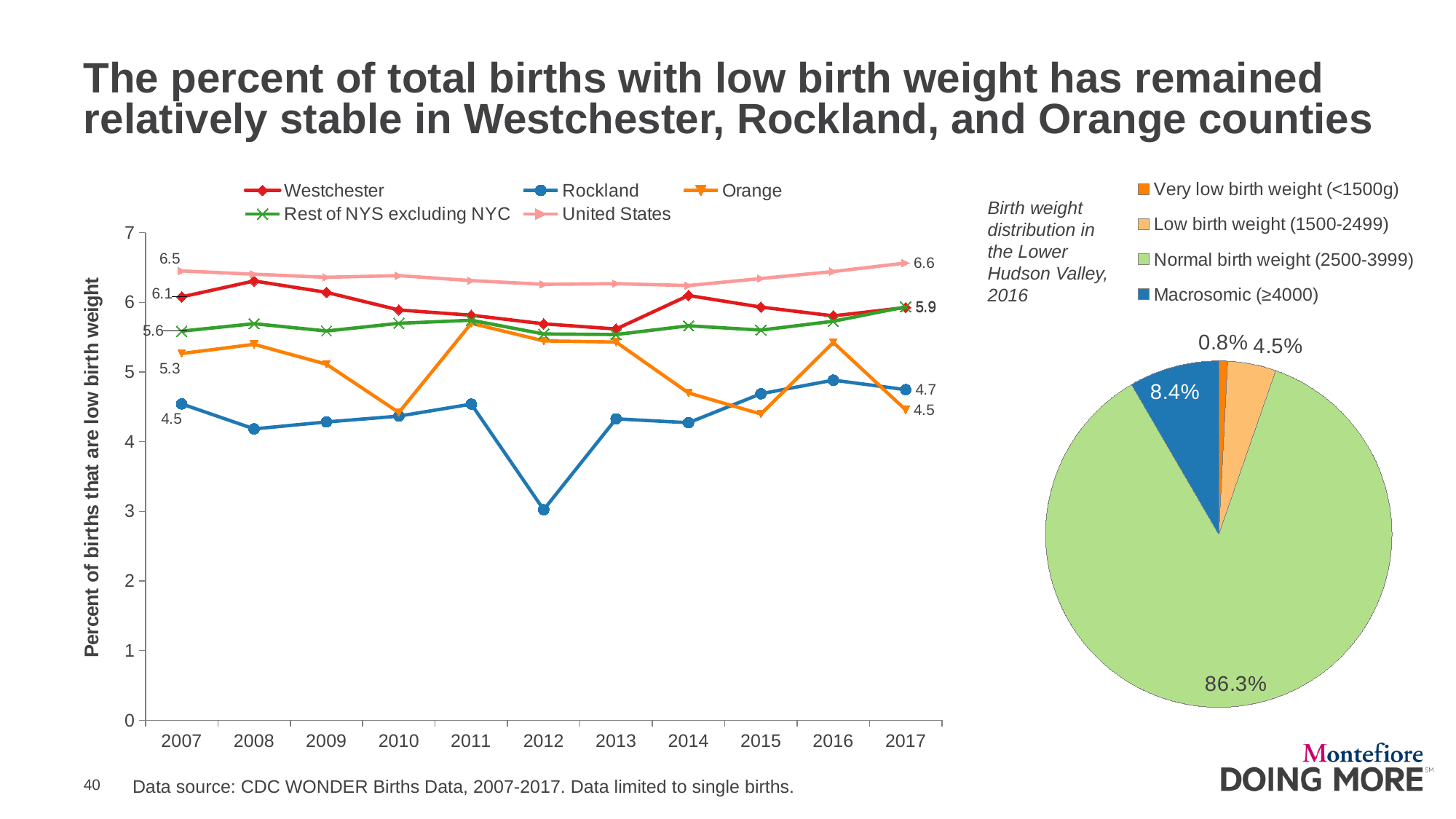
In the line chart on the left, how many years are shown on the x axis? 11 In the line chart on the left, how many series does the legend list? 5 In the line chart on the left, what was the percent of low birth weight births for the United States in 2007? 6.5 In the line chart on the left, which was higher in 2007: Westchester or Rockland? Westchester In the line chart on the left, which series had the lowest value in 2007? Rockland In the line chart on the left, is the value for Rockland in 2012 greater or less than 4? less In the line chart on the left, by how much did the United States value change from 2007 (6.5) to 2017 (6.6)? 0.1 In the pie chart 'Birth weight distribution in the Lower Hudson Valley, 2016', what share is Normal birth weight (2500-3999)? 86.3% What kind of chart is the chart on the left of the slide? Line chart In the line chart on the left, what was the percent of low birth weight births for Orange in 2007? 5.3 In the pie chart 'Birth weight distribution in the Lower Hudson Valley, 2016', how many slices are there? 4 In the line chart on the left, what was the percent of low birth weight births for Rockland in 2017? 4.7